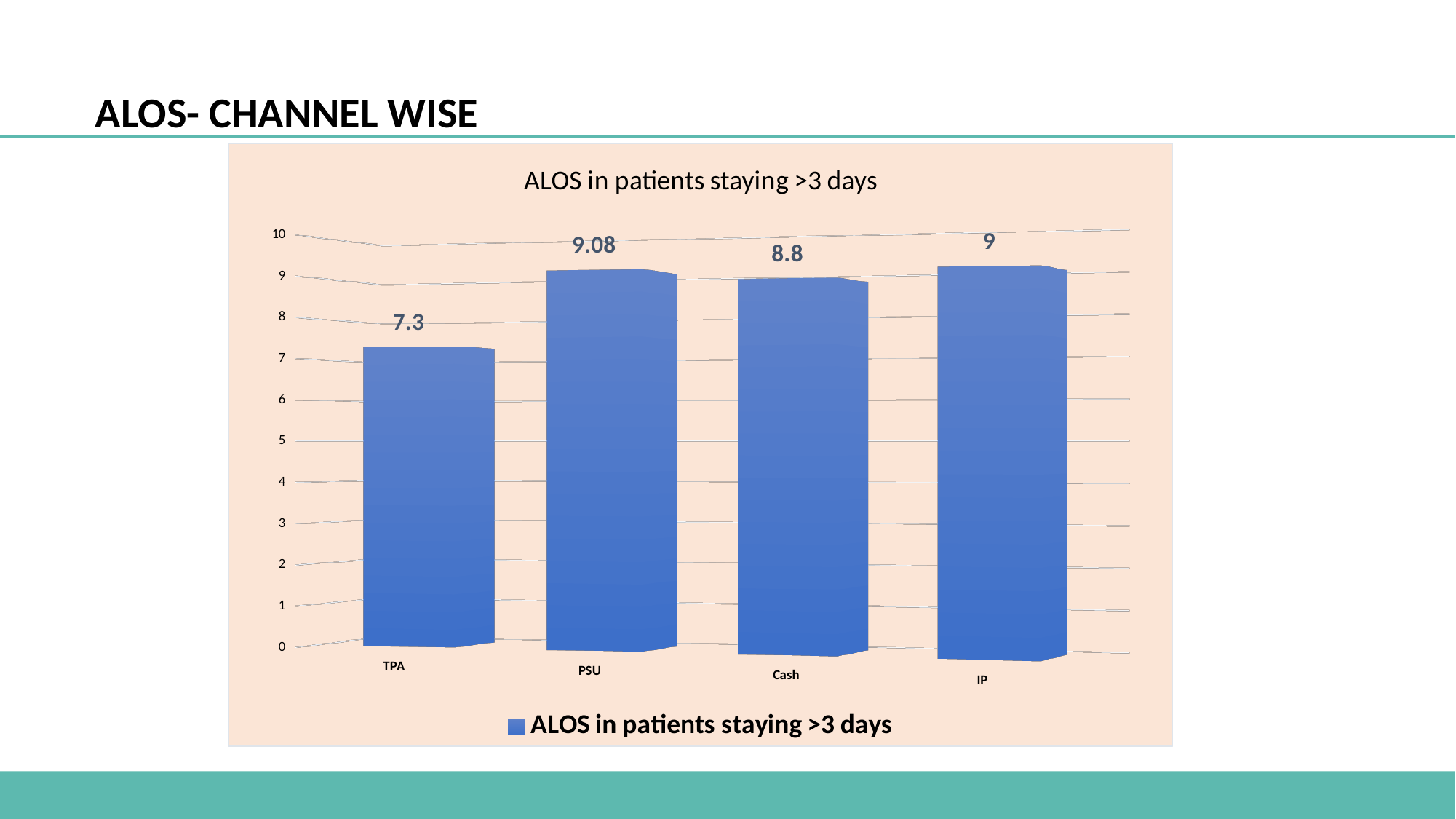
How many channels are shown on the chart? 4 What is the ALOS value for PSU? 9.08 Which has a higher ALOS, Cash or TPA? Cash Which channel has the lowest ALOS? TPA What is the difference between the ALOS for PSU and the ALOS for TPA? 1.78 How many series does the legend list? 1 What is the ALOS value for TPA? 7.3 What is the ALOS value for IP? 9 What is the ALOS value for Cash? 8.8 What kind of chart is shown on the slide? Bar chart What is the title of the chart? ALOS in patients staying >3 days Which channel has the highest ALOS? PSU